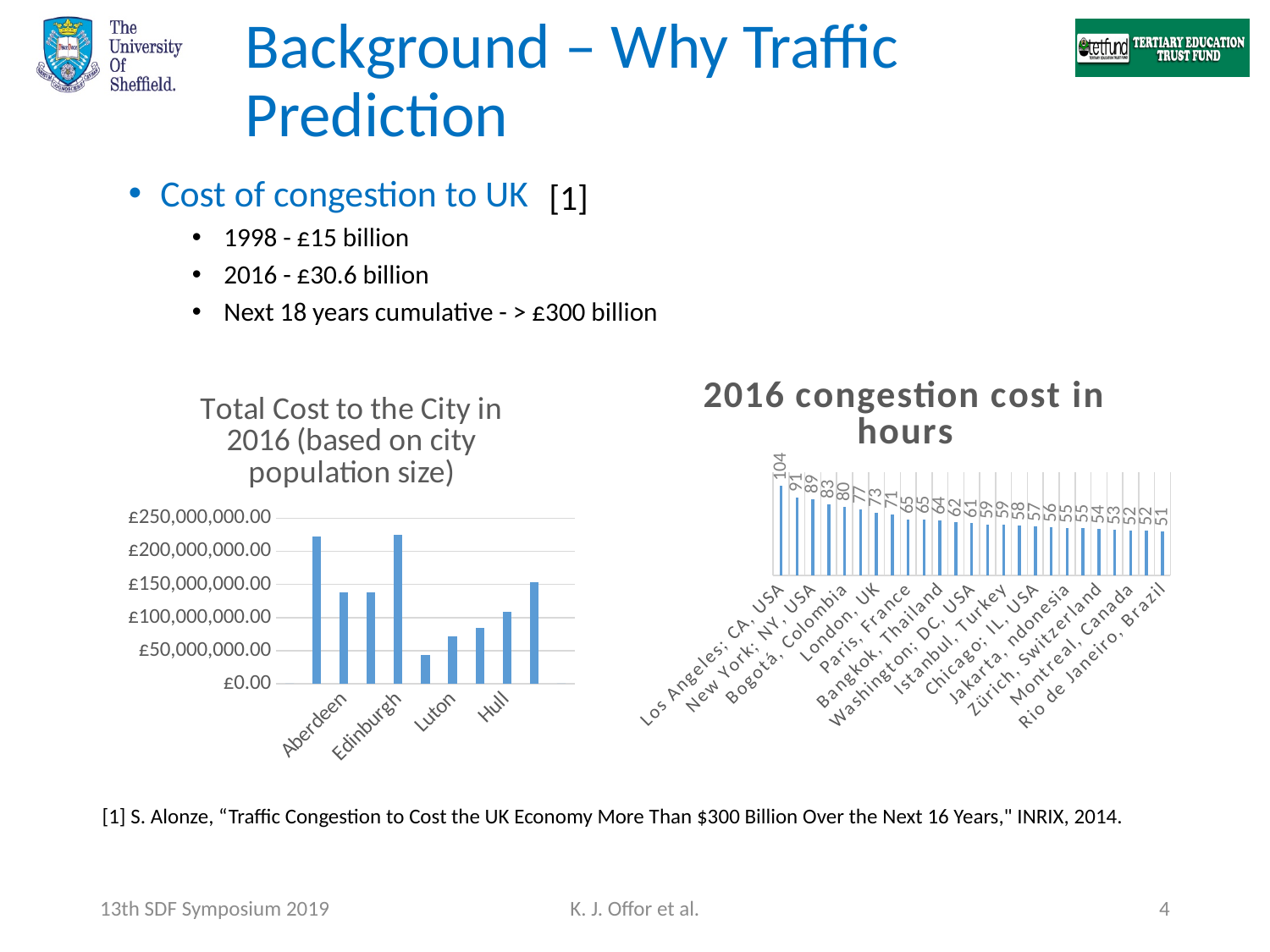
On the '2016 congestion cost in hours' chart, which city has the lowest value? Rio de Janeiro, Brazil On the 'Total Cost to the City in 2016' chart, is the value for Luton greater or less than £100,000,000.00? less On the '2016 congestion cost in hours' chart, how many bars are plotted? 25 On the '2016 congestion cost in hours' chart, what is the value for Los Angeles, CA, USA? 104 On the '2016 congestion cost in hours' chart, do the values rise or fall from left to right? fall On the '2016 congestion cost in hours' chart, what is the difference between the values for Los Angeles, CA, USA and Rio de Janeiro, Brazil? 53 On the '2016 congestion cost in hours' chart, which city has the highest value? Los Angeles, CA, USA On the '2016 congestion cost in hours' chart, which has the larger value, Los Angeles, CA, USA or New York, NY, USA? Los Angeles, CA, USA On the '2016 congestion cost in hours' chart, what is the value for Rio de Janeiro, Brazil? 51 On the '2016 congestion cost in hours' chart, what is the value for London, UK? 73 What kind of chart is the 'Total Cost to the City in 2016' chart on the left? bar chart On the 'Total Cost to the City in 2016' chart, how many bars are plotted? 9